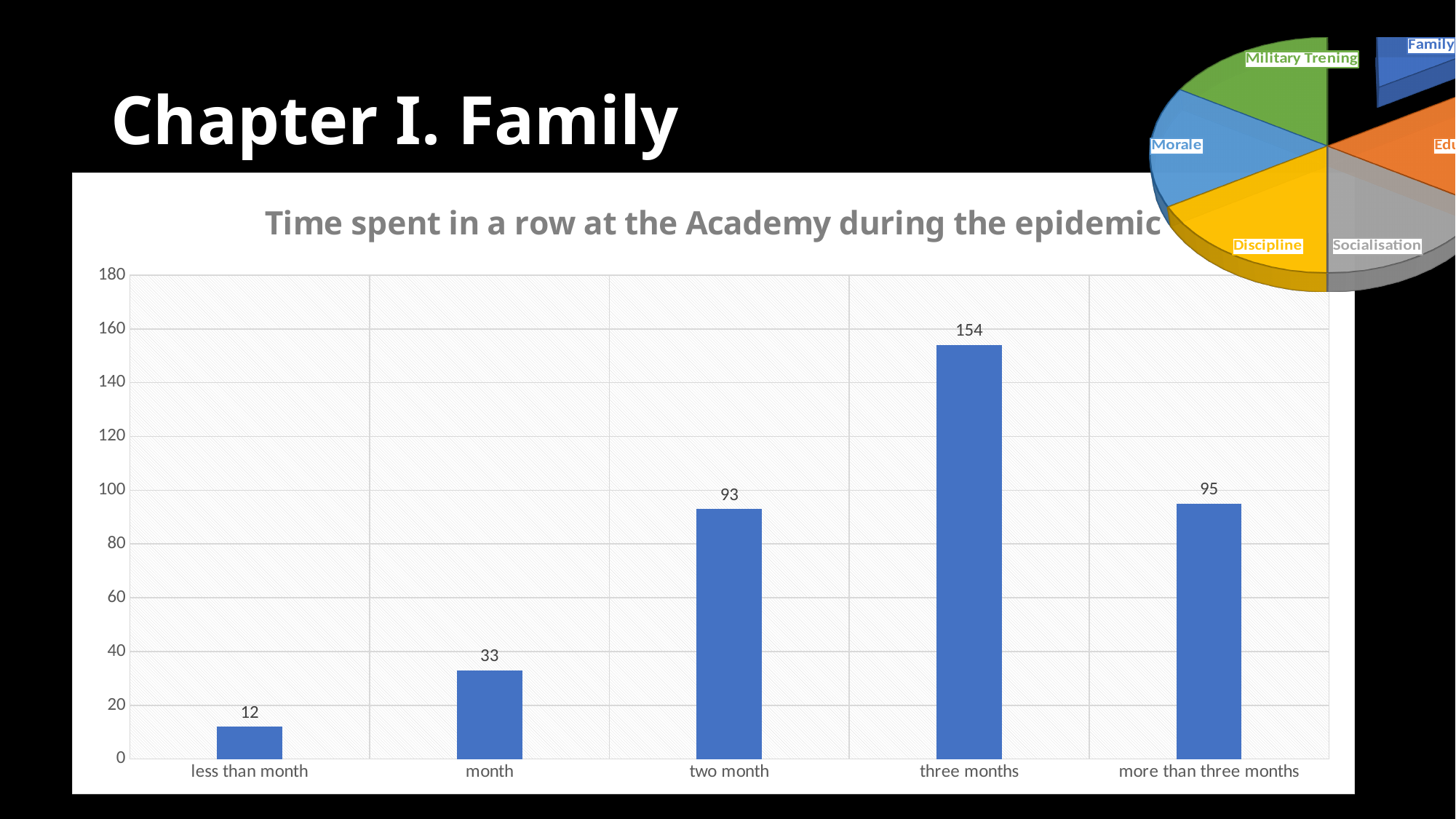
In the bar chart titled "Time spent in a row at the Academy during the epidemic", is the value for "month" greater or less than 40? less In the bar chart titled "Time spent in a row at the Academy during the epidemic", which category has the lowest value? less than month In the bar chart titled "Time spent in a row at the Academy during the epidemic", what is the difference between the values for "three months" and "month"? 121 In the bar chart titled "Time spent in a row at the Academy during the epidemic", what is the value for "two month"? 93 In the bar chart titled "Time spent in a row at the Academy during the epidemic", what is the value for "more than three months"? 95 In the bar chart titled "Time spent in a row at the Academy during the epidemic", what is the value for "less than month"? 12 What is the title of the bar chart on the slide? Time spent in a row at the Academy during the epidemic In the bar chart titled "Time spent in a row at the Academy during the epidemic", which is larger: the value for "two month" or "more than three months"? more than three months What kind of chart is the chart titled "Time spent in a row at the Academy during the epidemic"? bar chart How many categories are shown in the bar chart titled "Time spent in a row at the Academy during the epidemic"? 5 In the bar chart titled "Time spent in a row at the Academy during the epidemic", which category has the highest value? three months In the bar chart titled "Time spent in a row at the Academy during the epidemic", what is the value for "three months"? 154